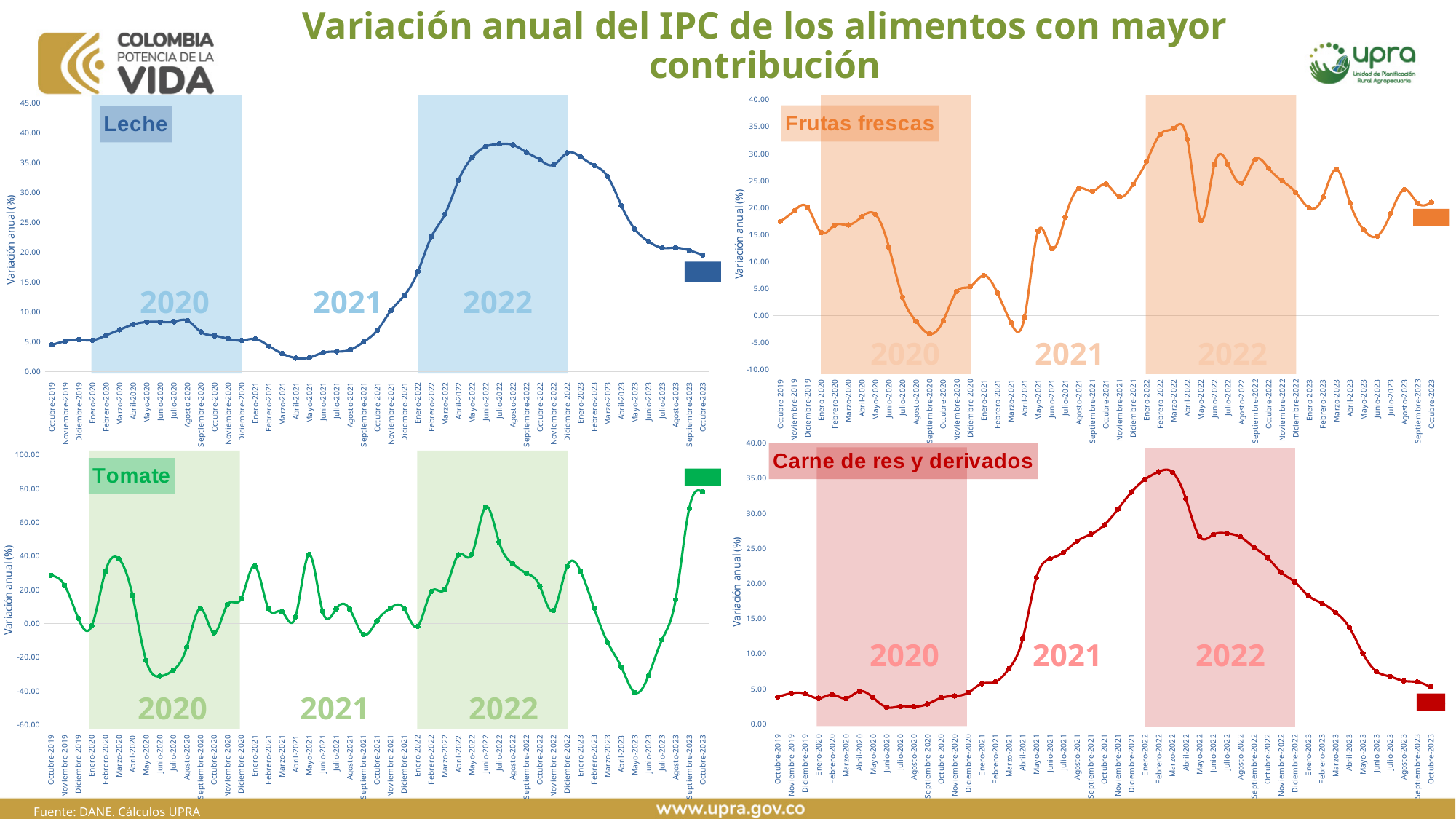
In the 'Tomate' chart, which month has the lowest value? Mayo-2023 In the 'Leche' chart, is the value for Julio-2022 greater or less than 35? greater How many charts are shown on the slide? 4 In the 'Frutas frescas' chart, is the value for Marzo-2022 greater or less than 30? greater In the 'Carne de res y derivados' chart, is the value for Junio-2020 greater or less than 5? less In the 'Carne de res y derivados' chart, do the values rise or fall from Marzo-2022 to Octubre-2023? fall In the 'Carne de res y derivados' chart, which is larger, the value for Marzo-2022 or the value for Octubre-2023? Marzo-2022 What kind of chart is the 'Leche' chart? line chart What is the title of the slide? Variación anual del IPC de los alimentos con mayor contribución